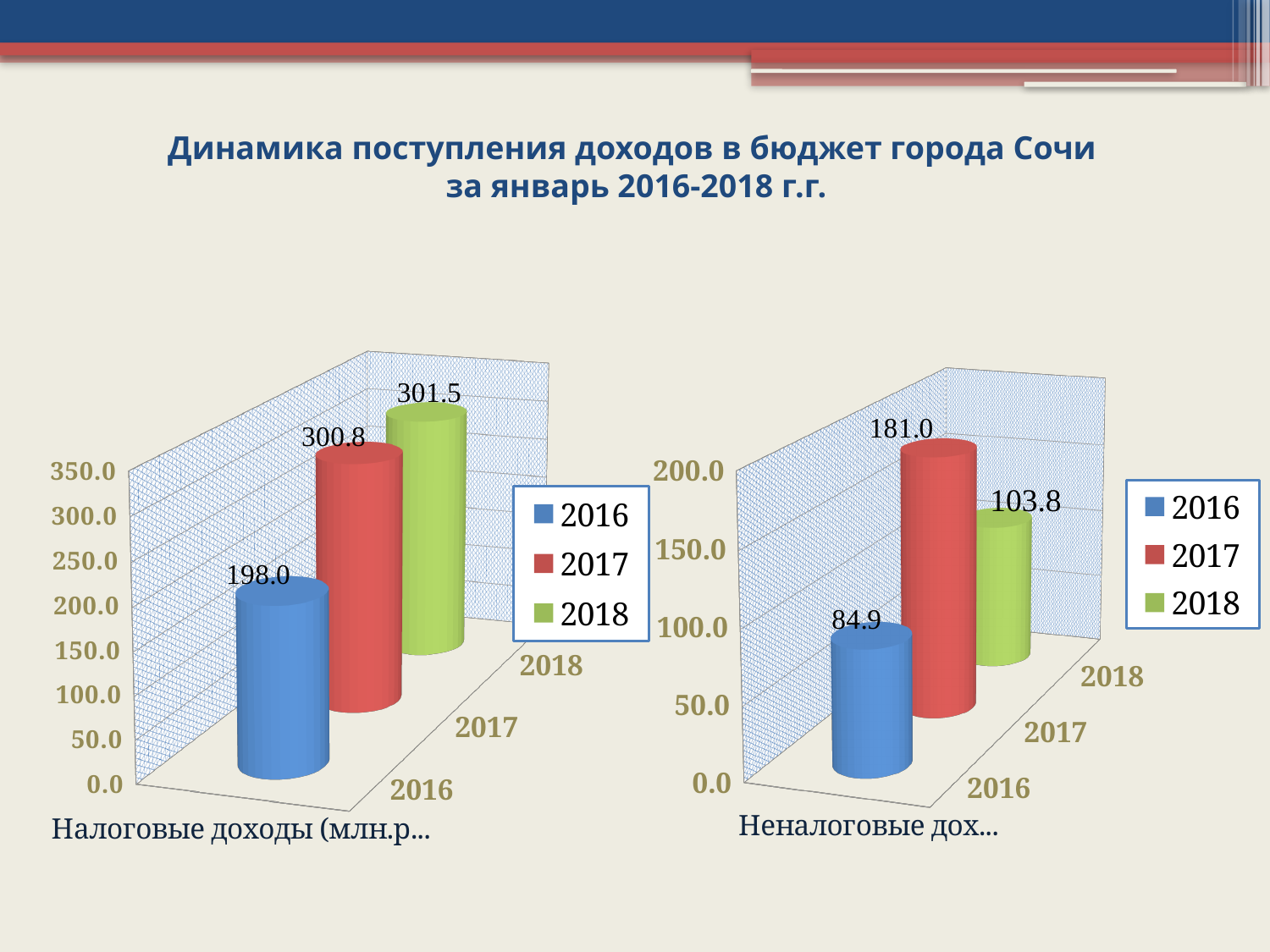
In the right chart (Неналоговые доходы), which year has the highest value? 2017 In the right chart (Неналоговые доходы), what is the value for 2017? 181.0 In the left chart (Налоговые доходы), which year has the lowest value? 2016 In the left chart (Налоговые доходы), what is the value for 2016? 198.0 In the right chart (Неналоговые доходы), which is larger, the value for 2018 or the value for 2016? 2018 In the left chart (Налоговые доходы), is the value for 2016 greater or less than 150.0? greater In the right chart (Неналоговые доходы), what is the difference between the 2017 and 2018 values? 77.2 What kind of chart is the left chart (Налоговые доходы)? bar chart In the left chart (Налоговые доходы), what is the difference between the 2017 and 2016 values? 102.8 In the right chart (Неналоговые доходы), what is the value for 2016? 84.9 How many series does the legend of the right chart (Неналоговые доходы) list? 3 In the left chart (Налоговые доходы), what is the value for 2018? 301.5